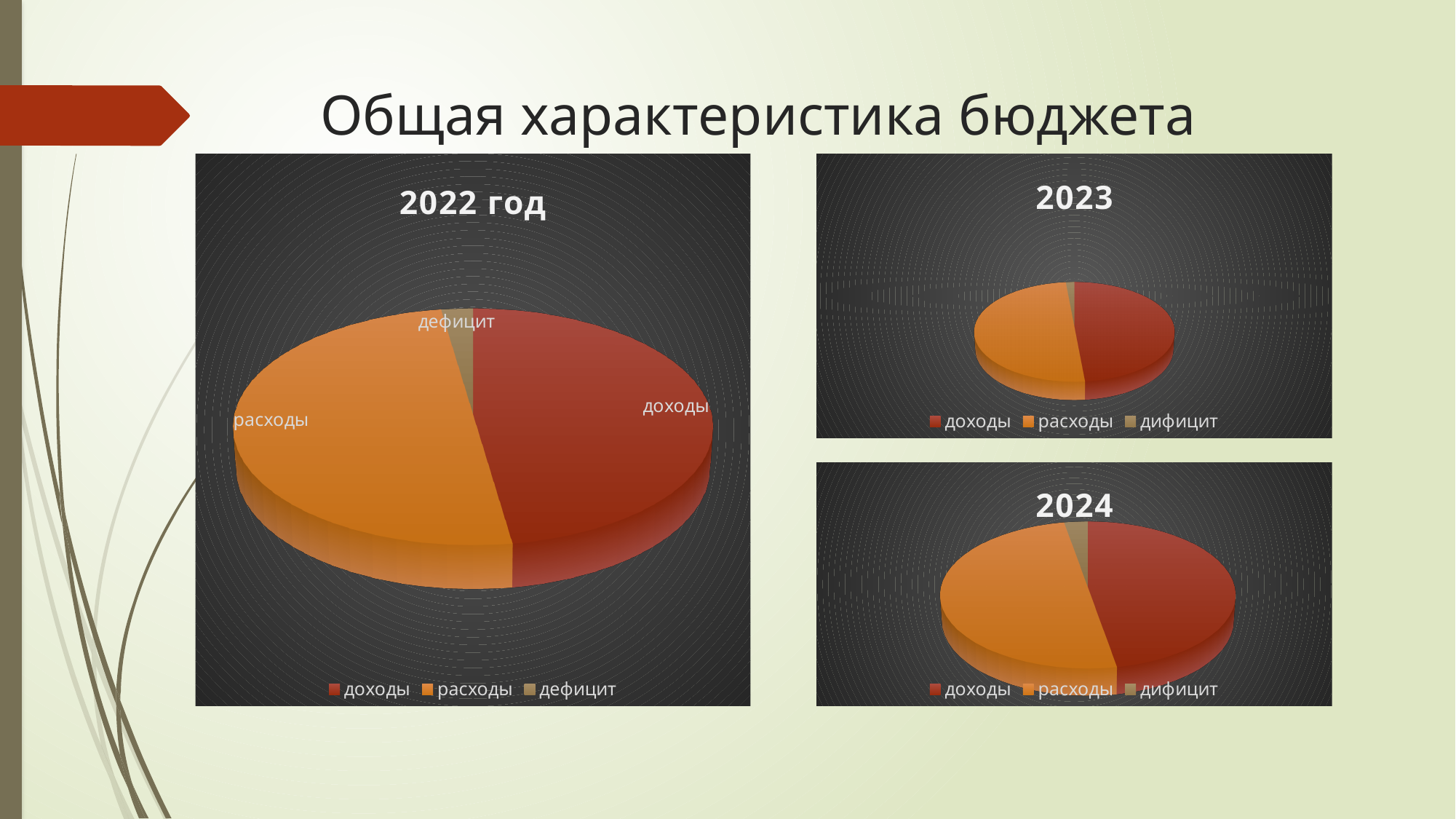
In the "2024" chart, which colour represents расходы? orange In the "2022 год" chart, which slice is larger: расходы or дефицит? расходы In the "2023" chart, which slice is larger: доходы or дифицит? доходы How many slices does the "2022 год" pie chart have? 3 In the "2024" chart, which category has the smallest slice? дифицит What is the title of the chart on the left side of the slide? 2022 год In the "2022 год" chart, which category has the smallest slice? дефицит How many charts are shown on the slide? 3 What kind of chart is the "2022 год" chart? pie chart How many entries does the legend of the "2023" chart list? 3 What kind of chart is the "2024" chart? pie chart